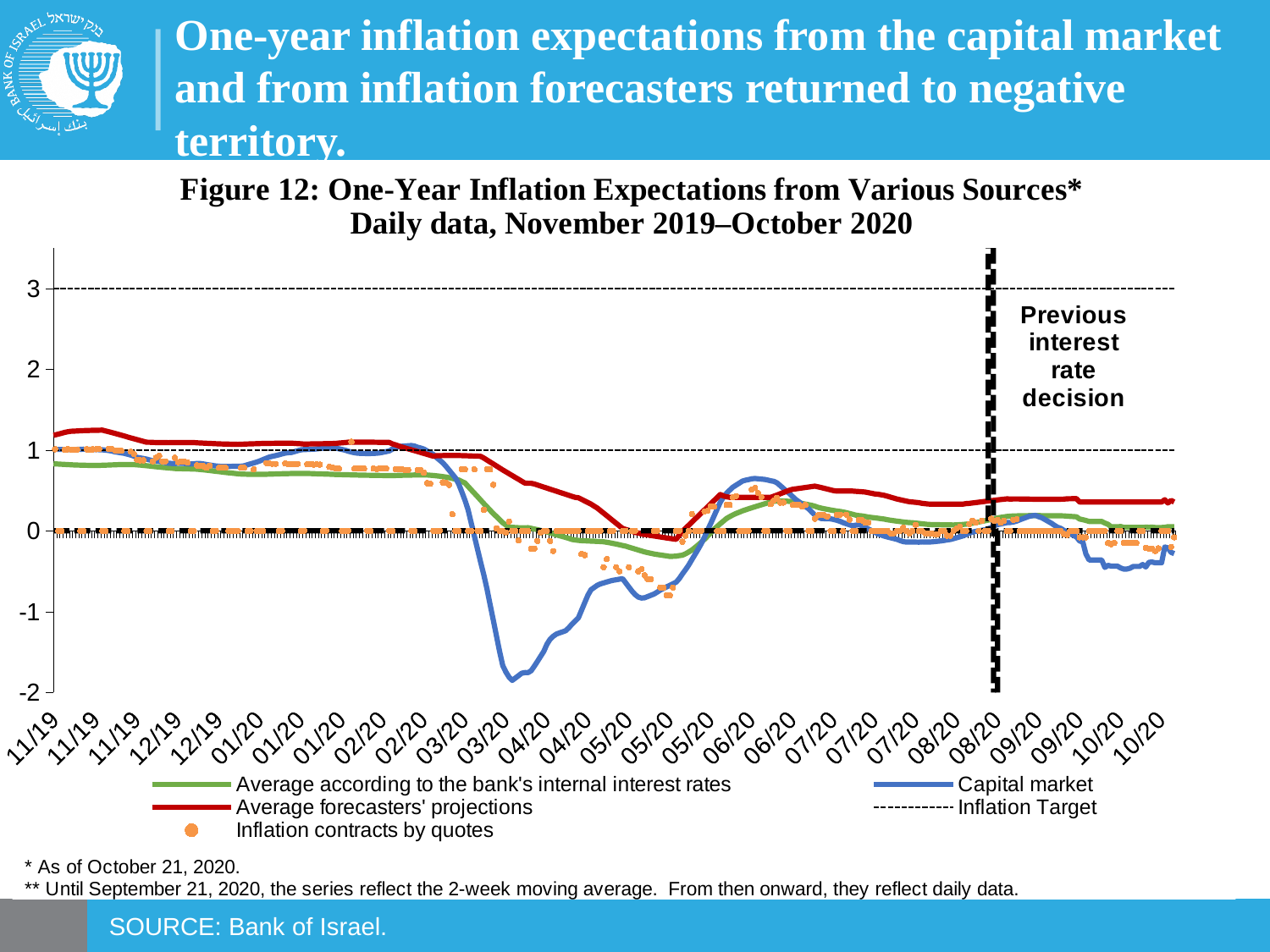
Is the value of the Average forecasters' projections series at the end of the period (10/20) greater or less than 0? greater How many series does the legend list? 5 What does the vertical dashed line near 08/20 mark? Previous interest rate decision What is the title of the figure? Figure 12: One-Year Inflation Expectations from Various Sources* Is the lowest value of the Capital market series, reached around 03/20, greater or less than -1? less Does the Capital market series rise or fall between 02/20 and 03/20? Fall Is the value of the Capital market series at the end of the period (10/20) greater or less than 0? less What kind of chart is shown on the slide? Line chart Which series has the lowest value around 03/20–04/20? Capital market Which series has the highest value at the end of the period (10/20)? Average forecasters' projections At what levels on the y axis are the Inflation Target dashed lines drawn? 1 and 3